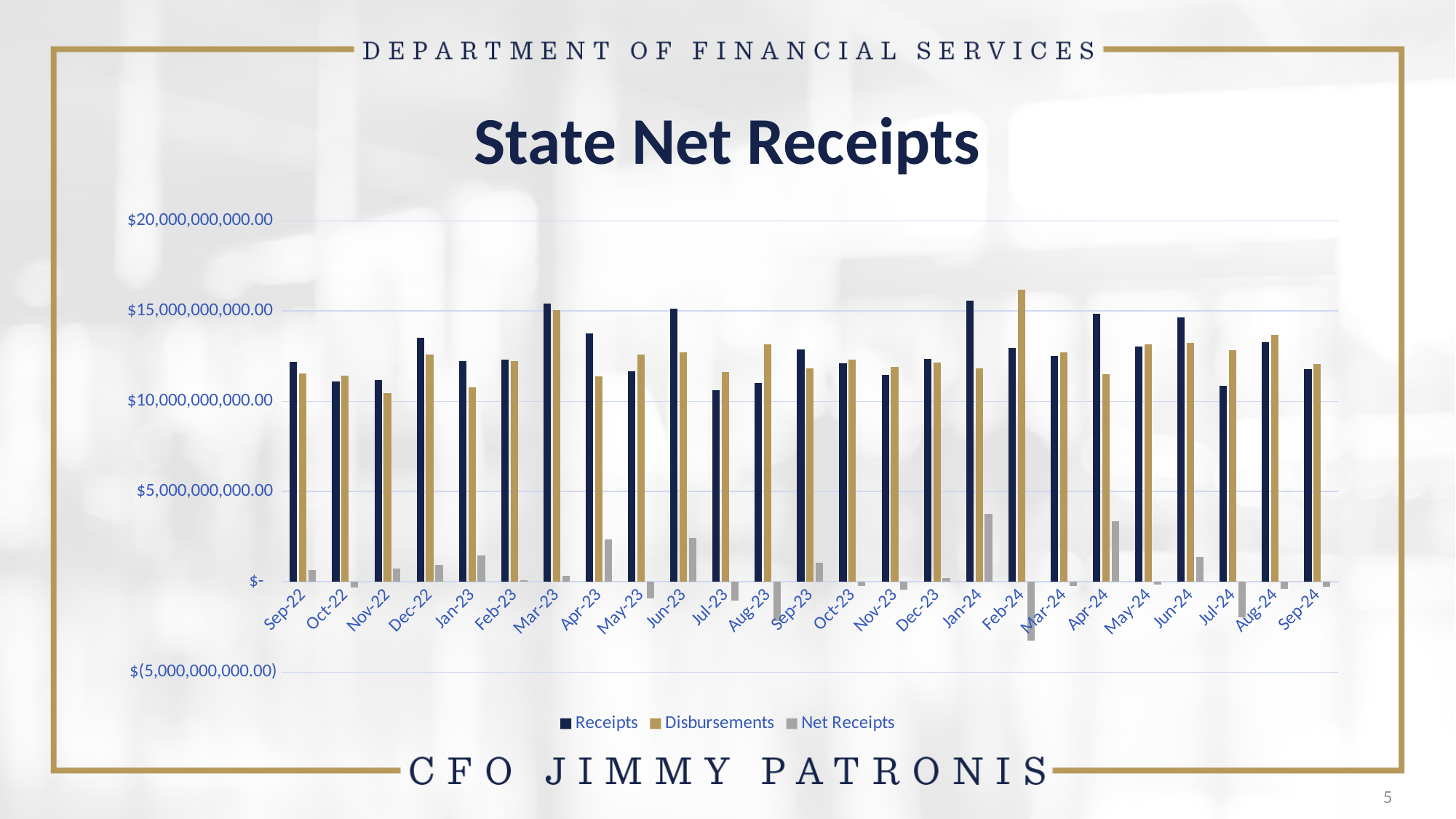
How many months are plotted along the x axis? 25 How many series does the legend list? 3 In Feb-24, which is larger, Receipts or Disbursements? Disbursements Is the value of Net Receipts for Jan-24 greater or less than $5,000,000,000.00? less Is the value of Disbursements for Feb-24 greater or less than $15,000,000,000.00? greater In which month are Disbursements highest? Feb-24 What is the title of the chart? State Net Receipts In which month are Net Receipts lowest? Feb-24 In Nov-22, which is larger, Receipts or Disbursements? Receipts What kind of chart is shown on the slide? Bar chart Which series is shown in gold bars? Disbursements Is the value of Receipts for Nov-22 greater or less than $15,000,000,000.00? less